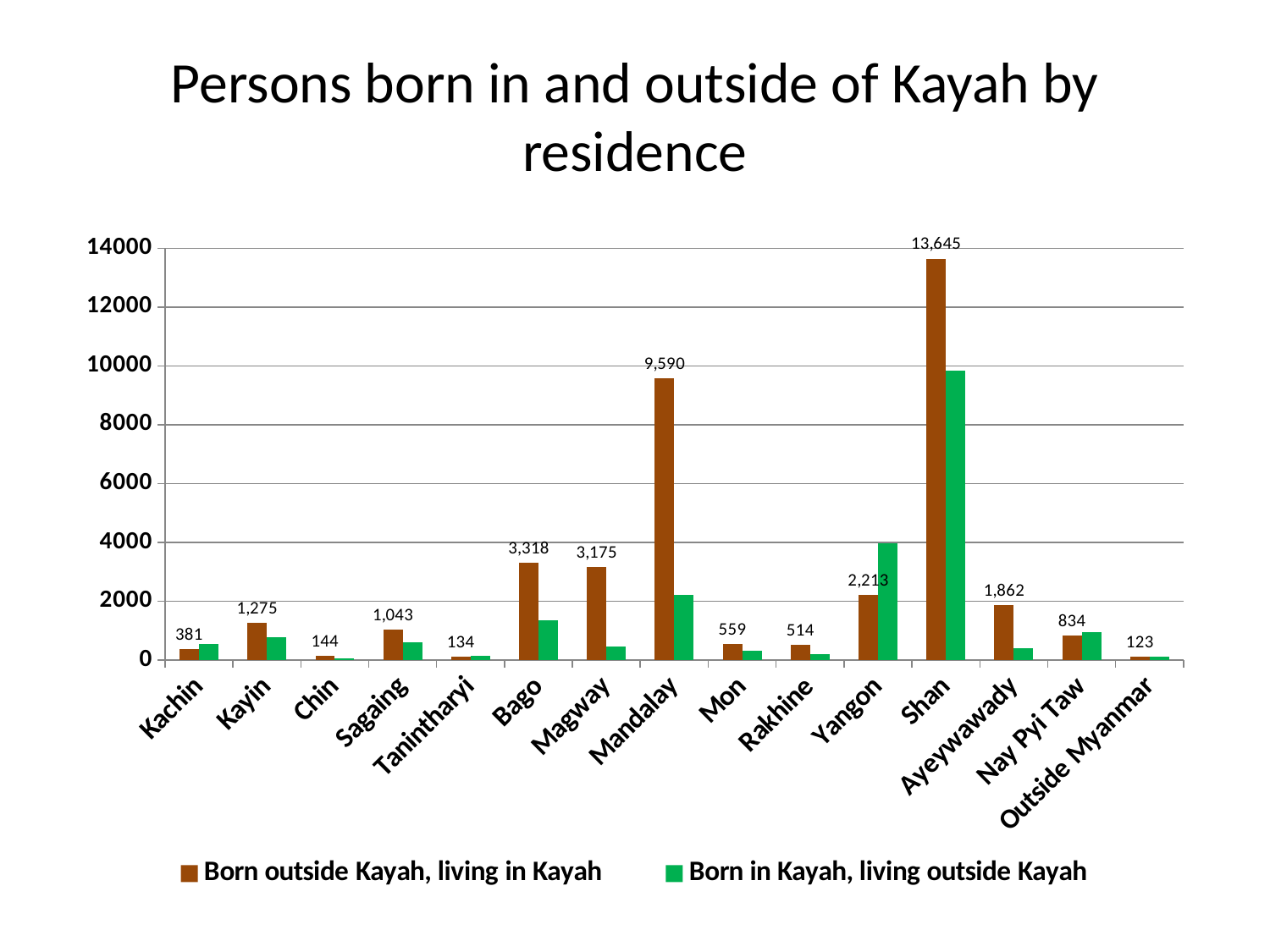
What is the difference between the 'Born outside Kayah, living in Kayah' values for Bago and Magway? 143 Which category has the highest value for 'Born outside Kayah, living in Kayah'? Shan What is the value for Shan in the 'Born outside Kayah, living in Kayah' series? 13,645 Which category has the lowest value for 'Born outside Kayah, living in Kayah'? Outside Myanmar Which is larger for 'Born outside Kayah, living in Kayah': Kayin or Sagaing? Kayin How many categories are shown on the x axis? 15 What kind of chart is shown on the slide? bar chart For Yangon, which series has the larger value: 'Born outside Kayah, living in Kayah' or 'Born in Kayah, living outside Kayah'? Born in Kayah, living outside Kayah What is the difference between the 'Born outside Kayah, living in Kayah' values for Shan and Mandalay? 4,055 What is the value for Mandalay in the 'Born outside Kayah, living in Kayah' series? 9,590 Is the value for Shan in the 'Born in Kayah, living outside Kayah' series greater or less than 8000? greater How many series does the legend list? 2